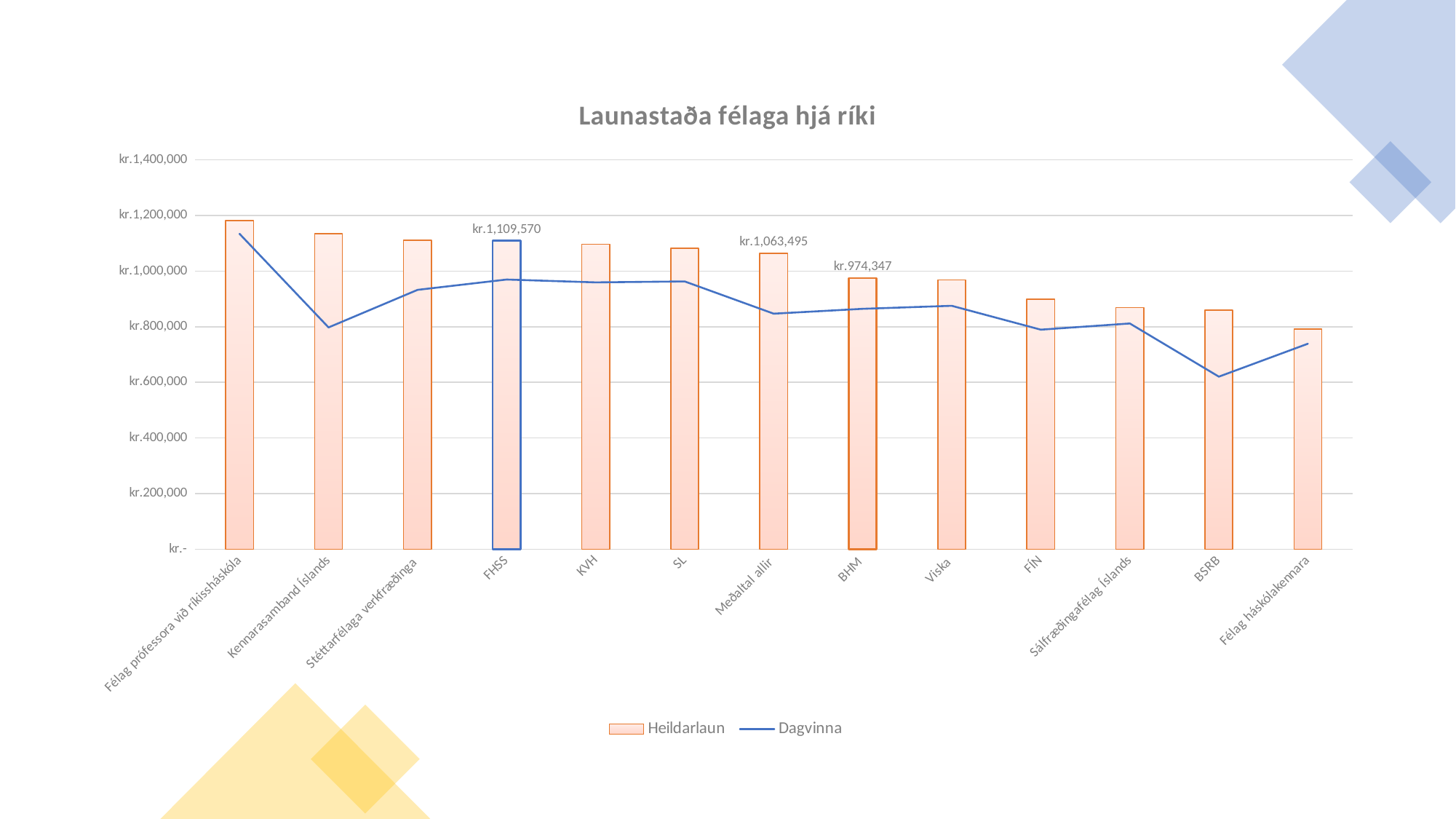
Which category has the lowest Dagvinna value on the line? BSRB How many categories are shown on the x axis? 13 How many series does the legend list? 2 Is the Heildarlaun value for Kennarasamband Íslands greater or less than kr.1,000,000? greater What is the difference between the Heildarlaun values for FHSS and BHM? kr.135,223 Is the Dagvinna value for BSRB greater or less than kr.800,000? less What is the Heildarlaun value for FHSS? kr.1,109,570 What is the Heildarlaun value for Meðaltal allir? kr.1,063,495 What is the Heildarlaun value for BHM? kr.974,347 Which category has the highest Heildarlaun bar? Félag prófessora við ríkissháskóla What is the title of the chart? Launastaða félaga hjá ríki Which has the larger Heildarlaun value, FHSS or BHM? FHSS